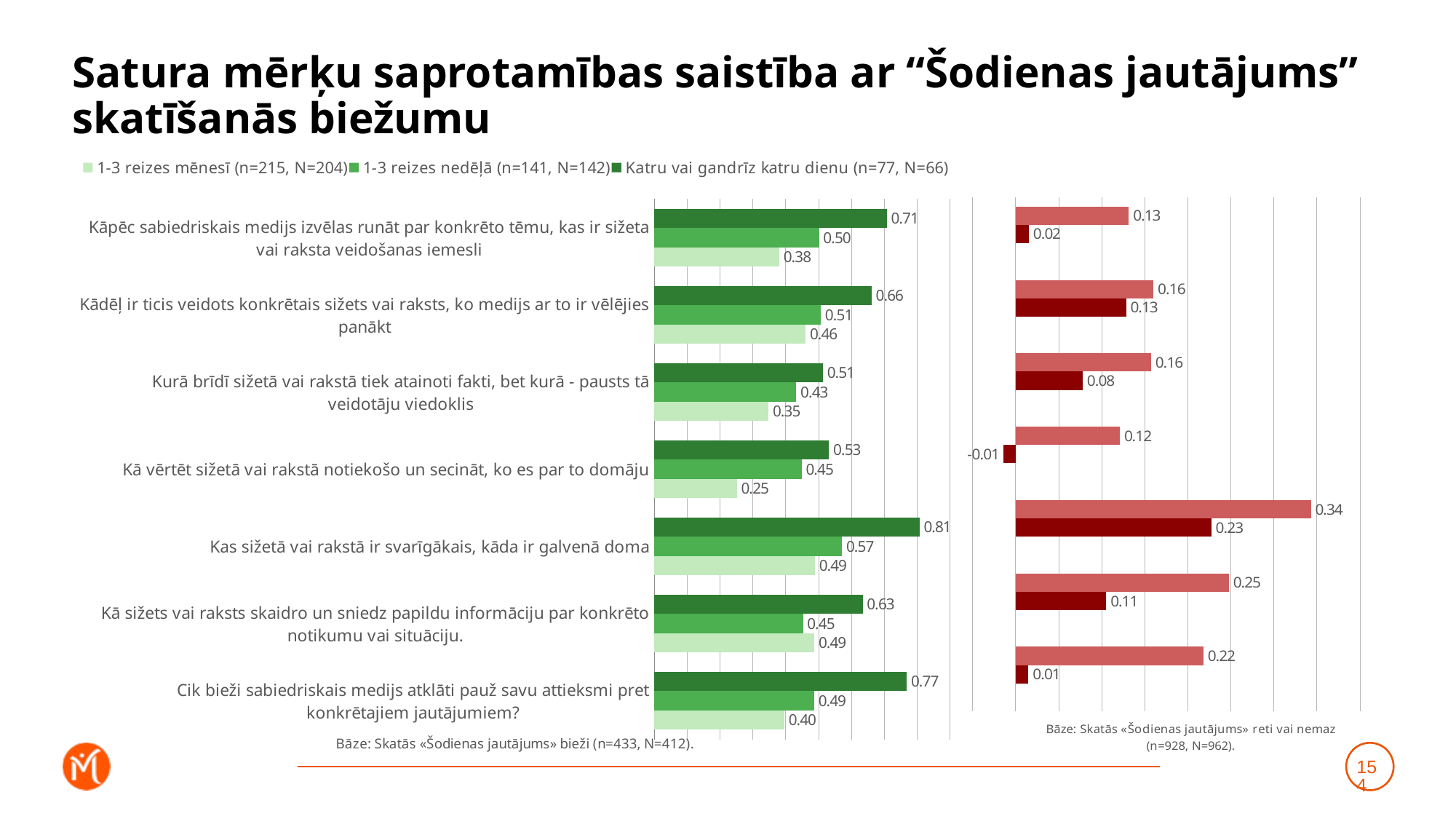
In the right (red) chart, what is the highest value shown? 0.34 In the left (green) chart, for the "1-3 reizes nedēļā" series, which is larger: the value for "Kas sižetā vai rakstā ir svarīgākais, kāda ir galvenā doma" or for "Kādēļ ir ticis veidots konkrētais sižets vai raksts, ko medijs ar to ir vēlējies panākt"? Kas sižetā vai rakstā ir svarīgākais, kāda ir galvenā doma What kind of chart is the left (green) chart? Bar chart In the left (green) chart, what is the value for "Katru vai gandrīz katru dienu" for the category "Kas sižetā vai rakstā ir svarīgākais, kāda ir galvenā doma"? 0.81 In the left (green) chart, what is the value for "1-3 reizes mēnesī" for the category "Kā vērtēt sižetā vai rakstā notiekošo un secināt, ko es par to domāju"? 0.25 In the right (red) chart, what is the lowest value shown? -0.01 How many categories are shown in the left (green) chart? 7 In the left (green) chart, what is the value for "1-3 reizes nedēļā" for the category "Kurā brīdī sižetā vai rakstā tiek atainoti fakti, bet kurā - pausts tā veidotāju viedoklis"? 0.43 In the left (green) chart, which category has the lowest value for the "1-3 reizes mēnesī" series? Kā vērtēt sižetā vai rakstā notiekošo un secināt, ko es par to domāju How many series does the legend of the left (green) chart list? 3 In the left (green) chart, what is the difference between the "Katru vai gandrīz katru dienu" value and the "1-3 reizes mēnesī" value for the category "Kāpēc sabiedriskais medijs izvēlas runāt par konkrēto tēmu, kas ir sižeta vai raksta veidošanas iemesli"? 0.33 In the left (green) chart, which category has the highest value for the "Katru vai gandrīz katru dienu" series? Kas sižetā vai rakstā ir svarīgākais, kāda ir galvenā doma